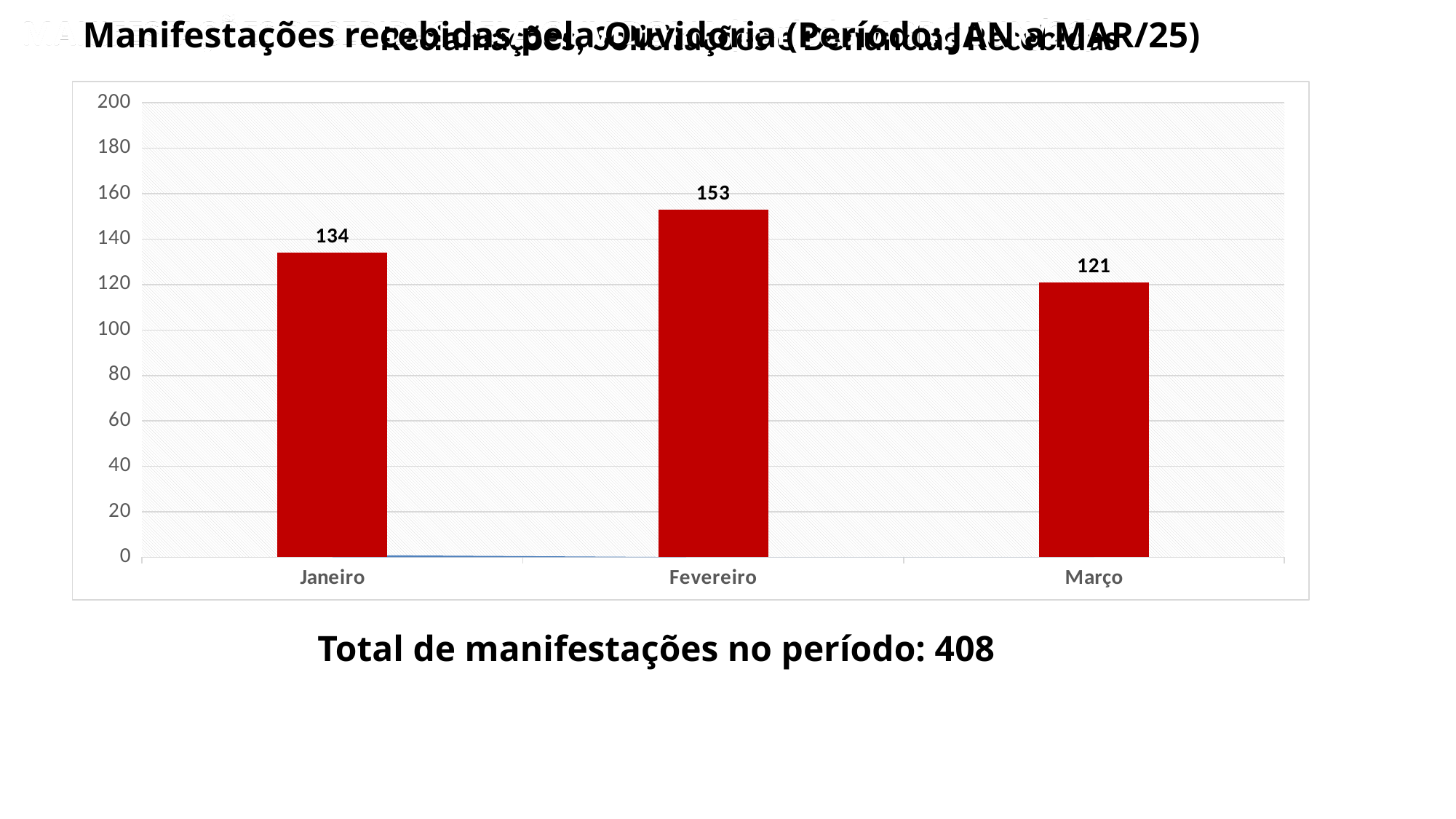
Is the value for Fevereiro greater or less than 140? greater What is the difference between the values for Janeiro and Março? 13 What is the difference between the values for Fevereiro and Janeiro? 19 Which month has the highest value? Fevereiro What kind of chart is shown on the slide? bar chart How many months are shown on the x axis? 3 What is the value for Janeiro? 134 What is the value for Fevereiro? 153 Which month has the lowest value? Março Which is larger, the value for Janeiro or the value for Março? Janeiro What is the total of the three monthly values shown? 408 What is the value for Março? 121